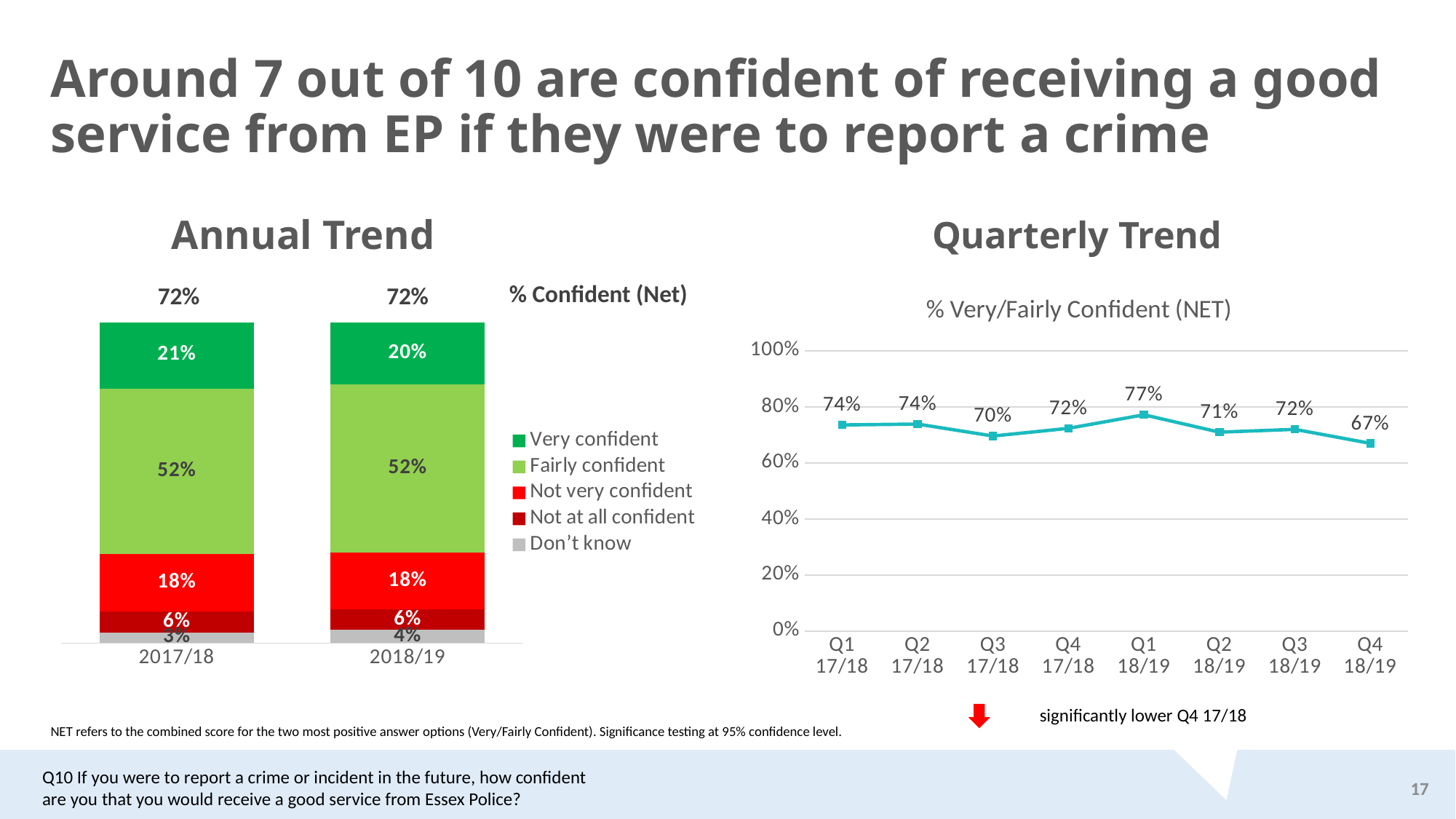
In the Quarterly Trend chart, what is the difference between Q1 18/19 and Q4 18/19? 10 percentage points In the Quarterly Trend chart, which quarter has the lowest value? Q4 18/19 In the Quarterly Trend chart, what is the value for Q1 18/19? 77% In the Annual Trend chart, what is the % Confident (Net) value for 2017/18? 72% In the Quarterly Trend chart, which quarter has the highest value? Q1 18/19 In the Quarterly Trend chart, how many quarters are plotted? 8 What kind of chart is the Quarterly Trend chart? Line chart In the Annual Trend chart, what percentage were Very confident in 2017/18? 21% In the Annual Trend chart, what is the Don't know value for 2018/19? 4% In the Annual Trend chart, what percentage were Fairly confident in 2018/19? 52% What kind of chart is the Annual Trend chart? Stacked bar chart In the Annual Trend chart, how many series does the legend list? 5